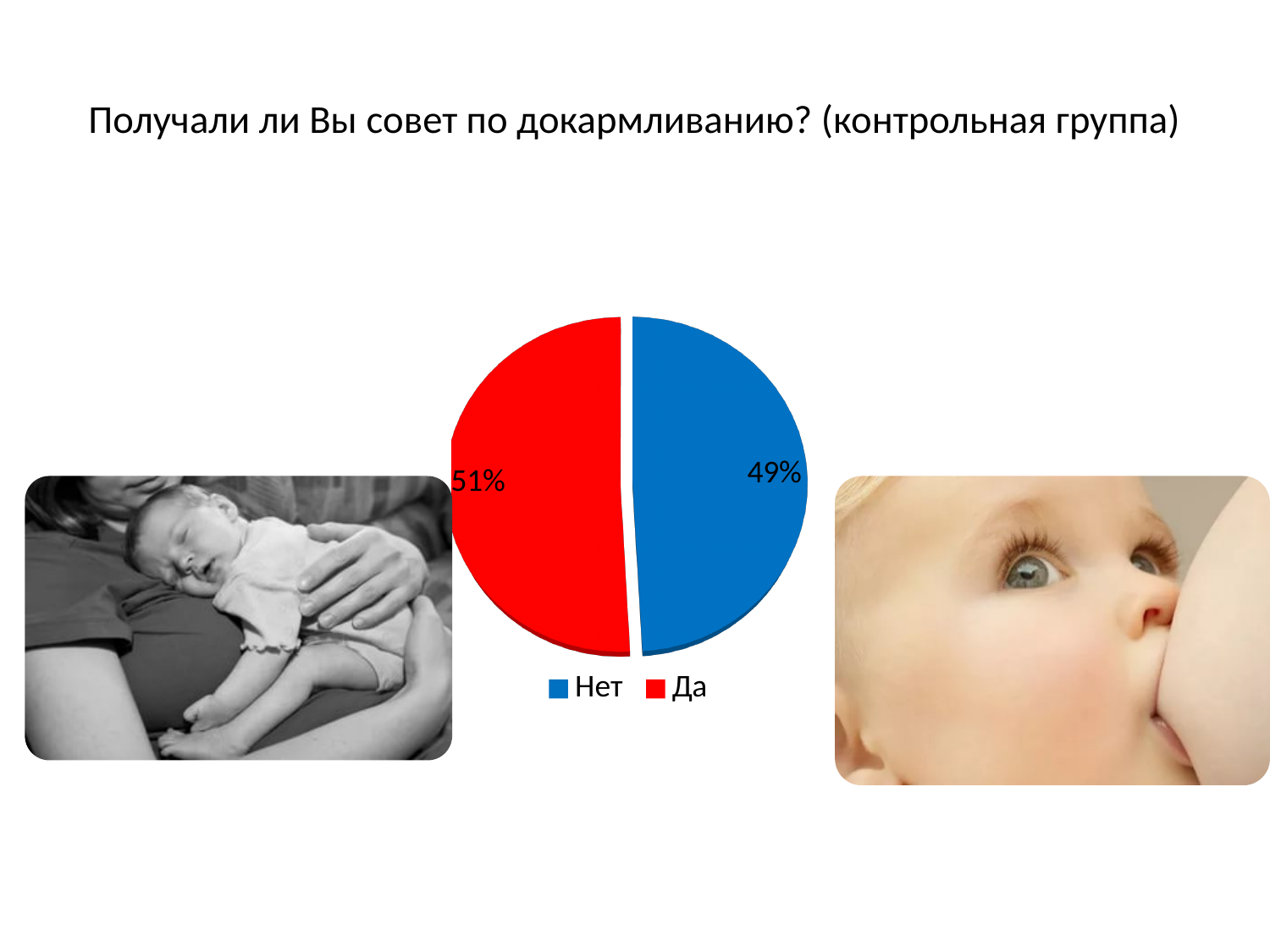
What kind of chart is shown on the slide? pie chart What colour is the "Нет" slice? blue What colour is the "Да" slice? red How many entries does the legend list? 2 What share of the pie does "Да" represent? 51% How many slices does the pie chart have? 2 Which slice is the largest? Да Which slice is the smallest? Нет What is the difference between the "Да" and "Нет" shares? 2% What share of the pie does "Нет" represent? 49%